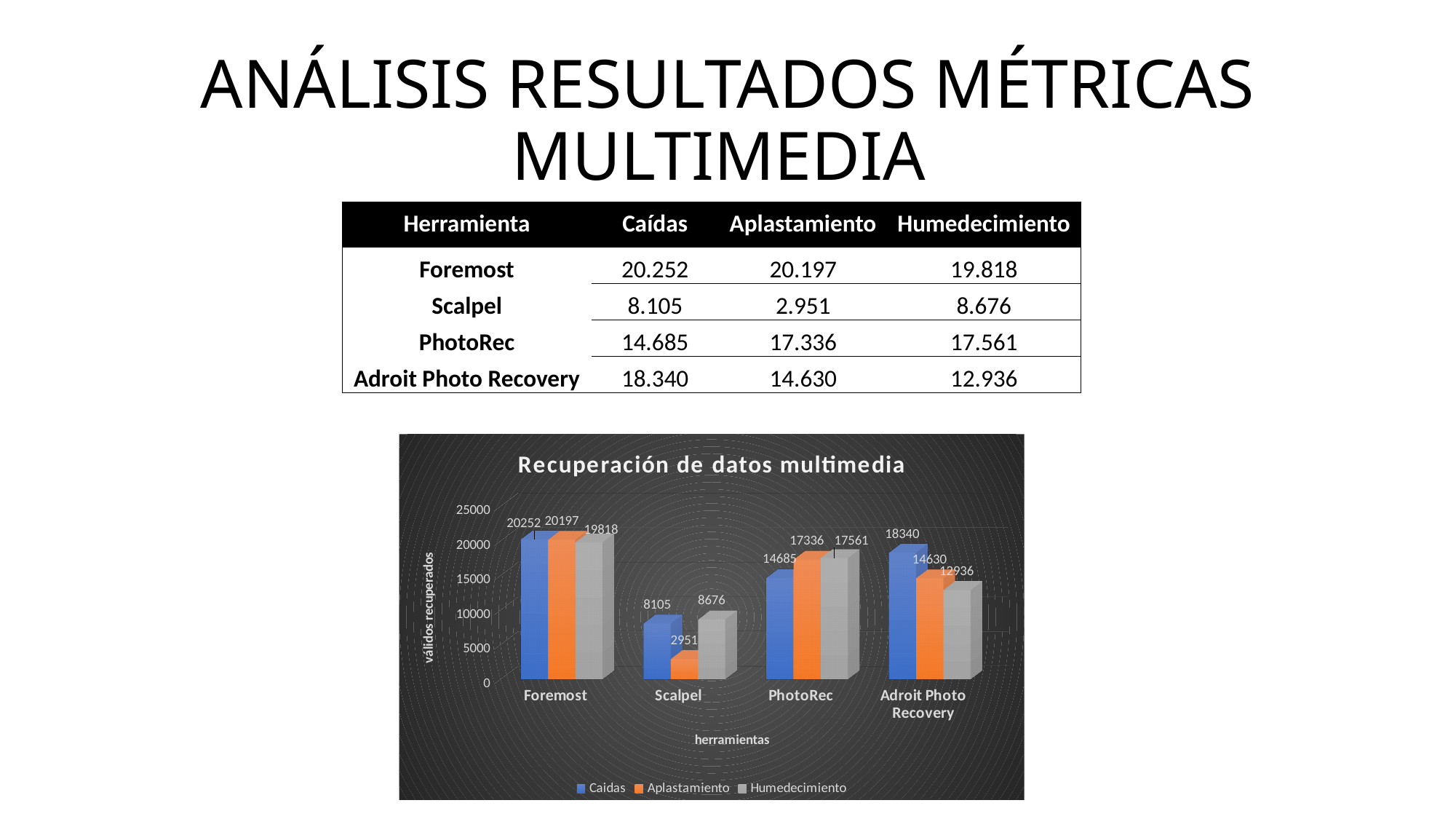
What is the difference between the Caidas and Aplastamiento values for Adroit Photo Recovery? 3710 How many series does the chart legend list? 3 What is the value for Foremost in the Caidas series? 20252 What is the value for Adroit Photo Recovery in the Caidas series? 18340 What is the value for Scalpel in the Aplastamiento series? 2951 Which is larger for PhotoRec: the Caidas value or the Aplastamiento value? Aplastamiento What is the value for PhotoRec in the Humedecimiento series? 17561 Which tool has the highest value in the Caidas series? Foremost Is the Humedecimiento value for Scalpel greater or less than 10000? less How many tools are shown on the x axis of the chart? 4 Which tool has the lowest value in the Aplastamiento series? Scalpel What is the title of the chart? Recuperación de datos multimedia